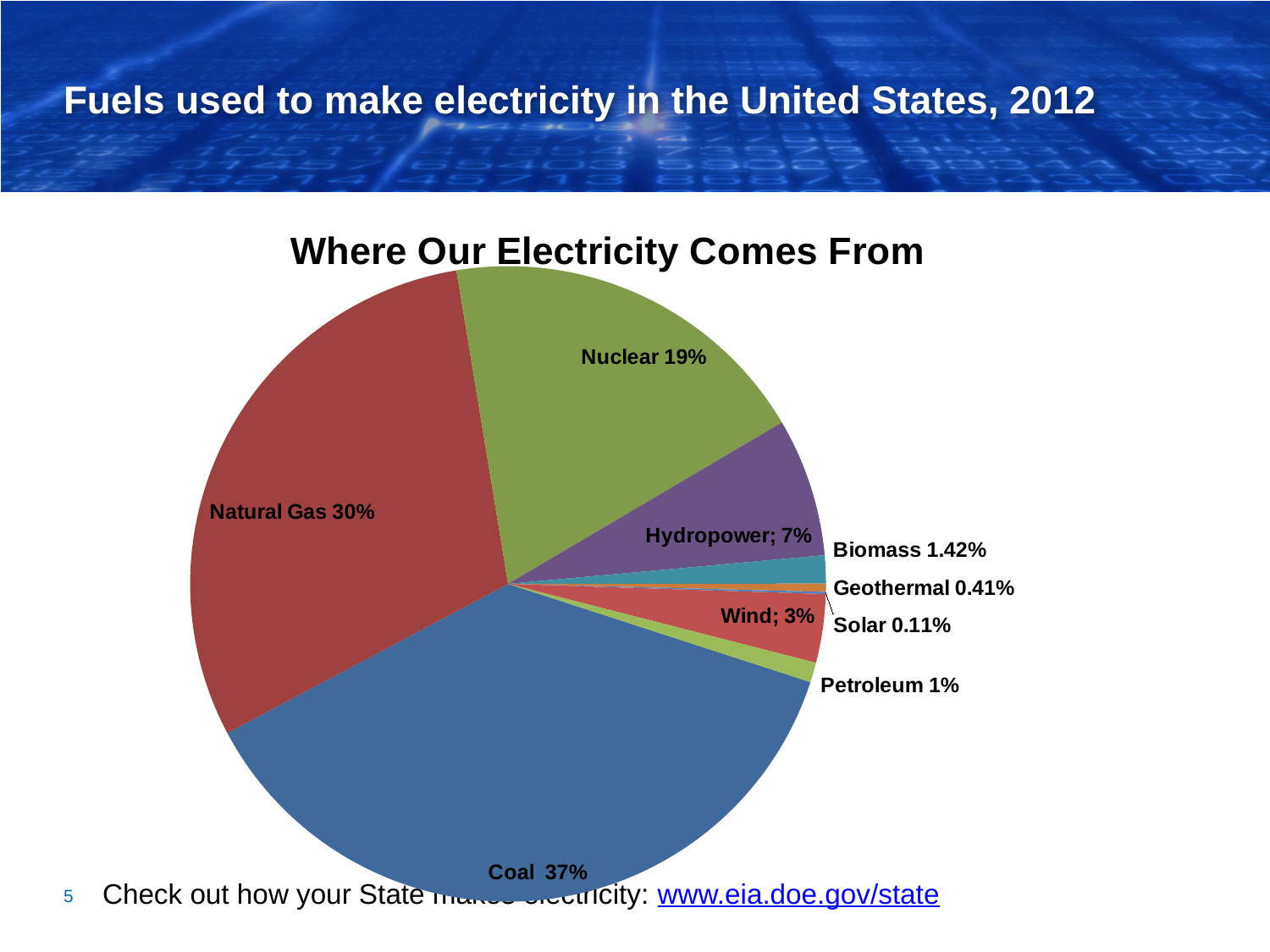
What is the difference in percentage points between the Coal share and the Natural Gas share? 7 Which is larger, the share for Hydropower or the share for Wind? Hydropower Which fuel has the largest slice of the pie? Coal What share of electricity comes from Nuclear? 19% What share of electricity comes from Geothermal? 0.41% How many fuel categories are shown in the pie chart? 9 What share of electricity comes from Natural Gas? 30% Which fuel has the smallest slice of the pie? Solar What share of electricity comes from Coal? 37% What is the title of the chart? Where Our Electricity Comes From What kind of chart is shown on the slide? pie chart What share of electricity comes from Biomass? 1.42%